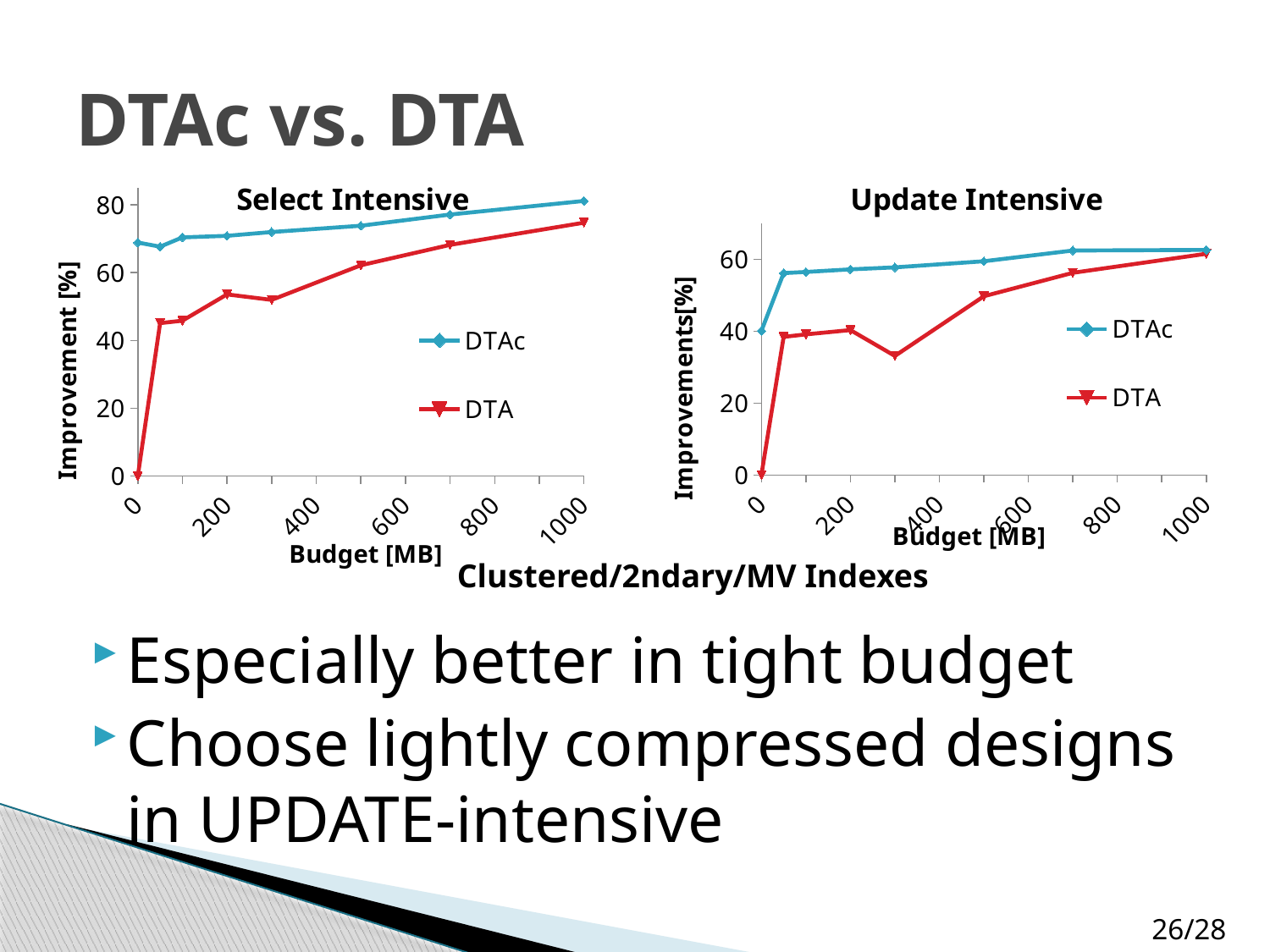
In the Select Intensive chart, is the DTA value at budget 1000 greater or less than 60? greater In the Select Intensive chart, is the DTAc value at budget 0 greater or less than 60? greater What is the x-axis label of the Update Intensive chart? Budget [MB] In the Update Intensive chart, is the DTA value at budget 300 greater or less than 40? less What kind of chart is the Select Intensive chart? line chart In the Select Intensive chart, at budget 200, which series has the higher improvement, DTAc or DTA? DTAc In the Select Intensive chart, which series is drawn in red? DTA In the Update Intensive chart, at budget 300, which series has the higher improvement, DTAc or DTA? DTAc In the Select Intensive chart, does the DTAc series generally rise or fall as the budget increases? rise How many series does the legend of the Update Intensive chart list? 2